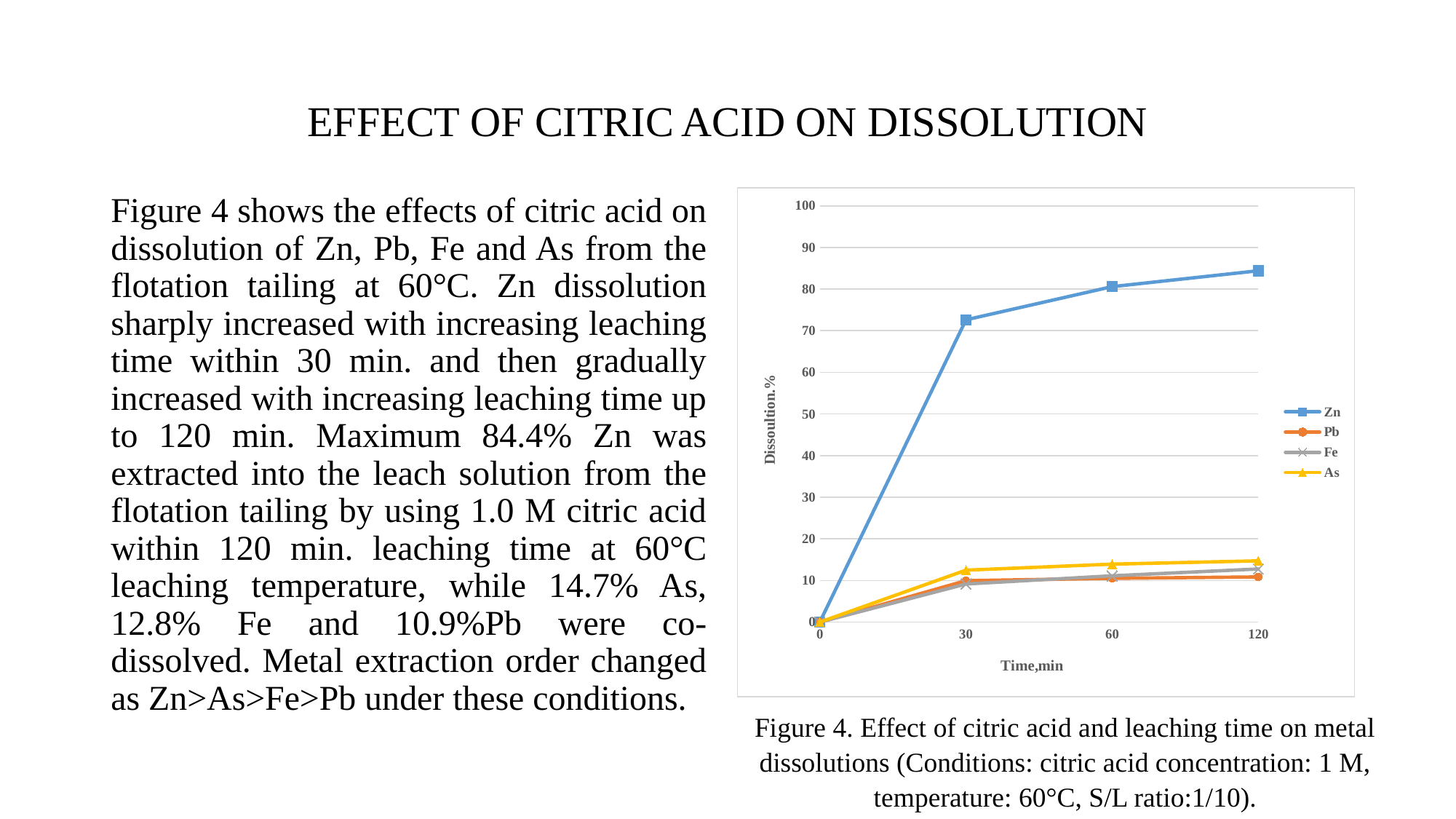
Which series has the highest dissolution at 120 min? Zn Does the Zn dissolution rise or fall as leaching time increases from 0 to 120 min? rise How many series does the chart legend list? 4 Is the Zn dissolution at 120 min greater or less than 80? greater Which is larger at 60 min, the Zn dissolution or the As dissolution? Zn What is the label of the x axis? Time,min What colour is the Zn series line? blue Is the Zn dissolution at 30 min greater or less than 60? greater What kind of chart is shown on the slide? line chart How many time points are plotted along the x axis? 4 Which series has the lowest dissolution at 120 min? Pb Is the As dissolution at 30 min greater or less than 20? less